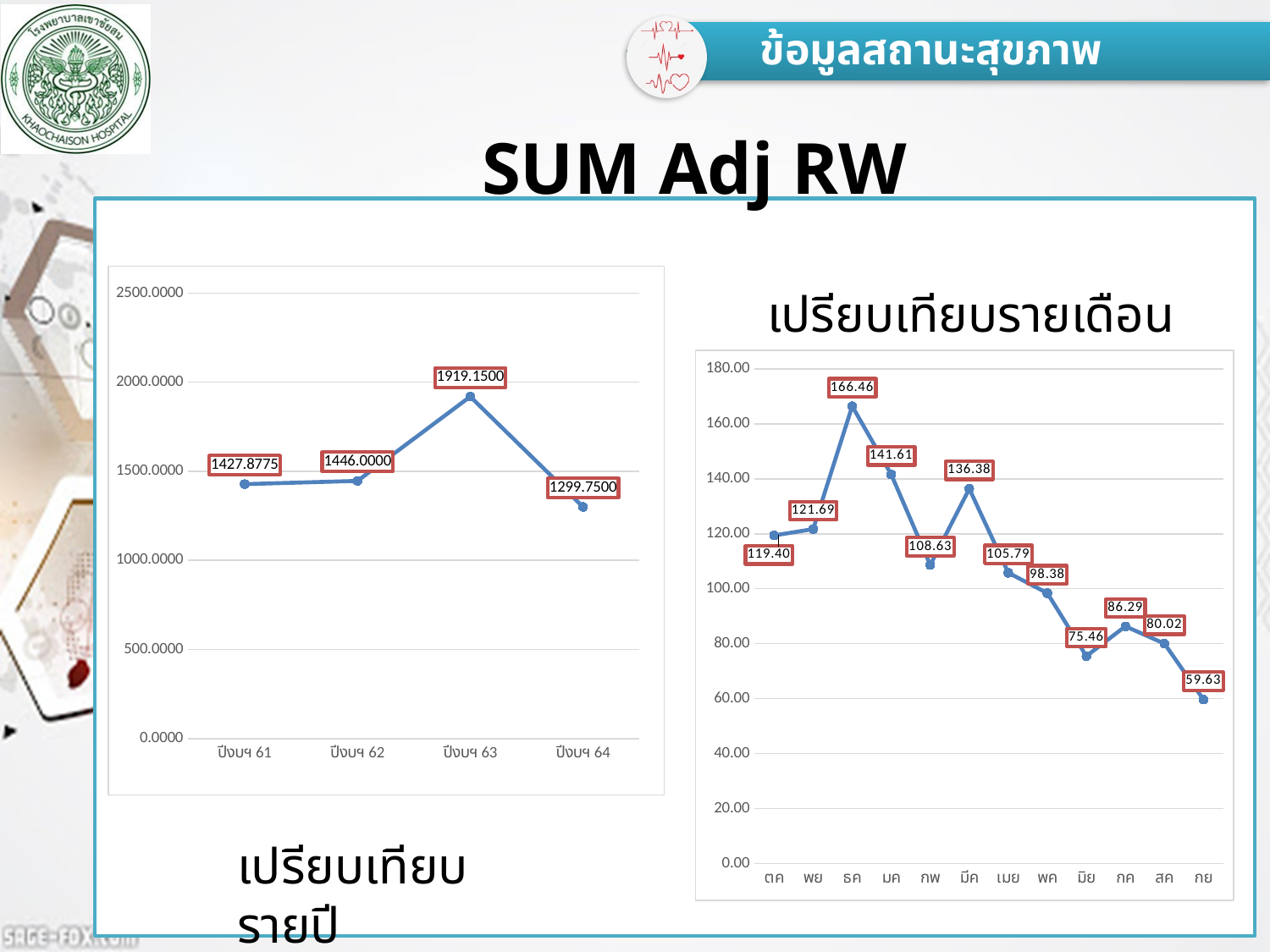
In the left chart (เปรียบเทียบรายปี), what is the value for ปีงบฯ 63? 1919.1500 In the right chart (เปรียบเทียบรายเดือน), which month has the highest value? ธค In the right chart (เปรียบเทียบรายเดือน), which is larger, the value for มีค or the value for มค? มค In the right chart (เปรียบเทียบรายเดือน), do the values generally rise or fall from เมย to กย? Fall In the right chart (เปรียบเทียบรายเดือน), how many months are plotted? 12 In the right chart (เปรียบเทียบรายเดือน), what is the value for ธค? 166.46 In the left chart (เปรียบเทียบรายปี), how many years are plotted? 4 In the right chart (เปรียบเทียบรายเดือน), what is the difference between the values for กค and มิย? 10.83 In the left chart (เปรียบเทียบรายปี), what is the difference between the values for ปีงบฯ 63 and ปีงบฯ 64? 619.4000 In the right chart (เปรียบเทียบรายเดือน), what is the value for กย? 59.63 What type of chart is the left chart (เปรียบเทียบรายปี)? Line chart In the left chart (เปรียบเทียบรายปี), which year has the lowest value? ปีงบฯ 64